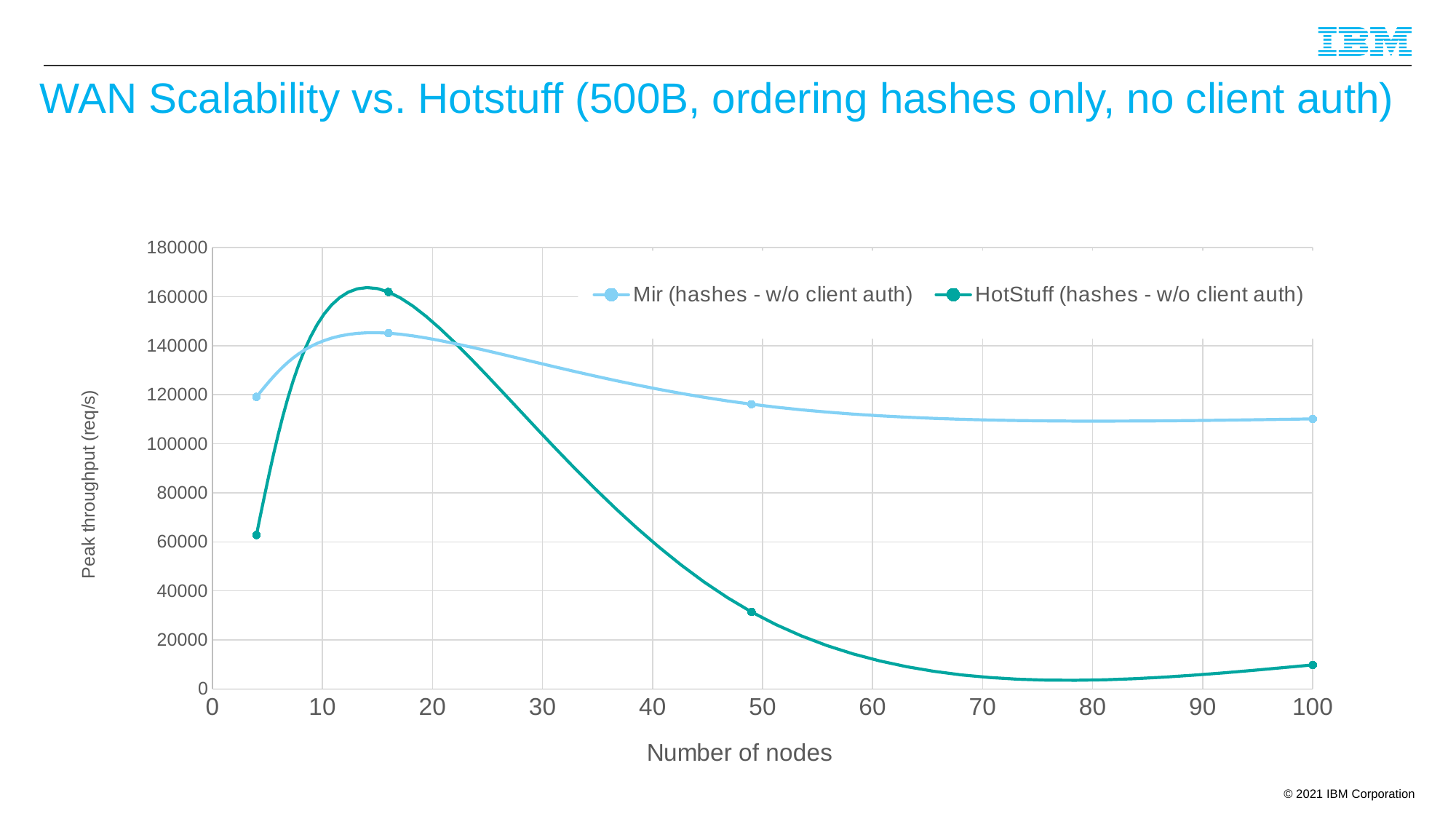
At which number of nodes does the HotStuff (hashes - w/o client auth) series reach its highest peak throughput? 16 At which number of nodes is the HotStuff (hashes - w/o client auth) series lowest? 100 What is the label of the x axis? Number of nodes Is the peak throughput for Mir (hashes - w/o client auth) at 4 nodes greater or less than 100000? greater How many series does the legend list? 2 Does the HotStuff (hashes - w/o client auth) series rise or fall between 16 and 100 nodes? fall Is the peak throughput for HotStuff (hashes - w/o client auth) at 16 nodes greater or less than 140000? greater What kind of chart is shown on the slide? line chart Is the peak throughput for HotStuff (hashes - w/o client auth) at 4 nodes greater or less than 80000? less How many data points are plotted for the HotStuff (hashes - w/o client auth) series? 4 At 49 nodes, which series has the higher peak throughput, Mir or HotStuff? Mir (hashes - w/o client auth)